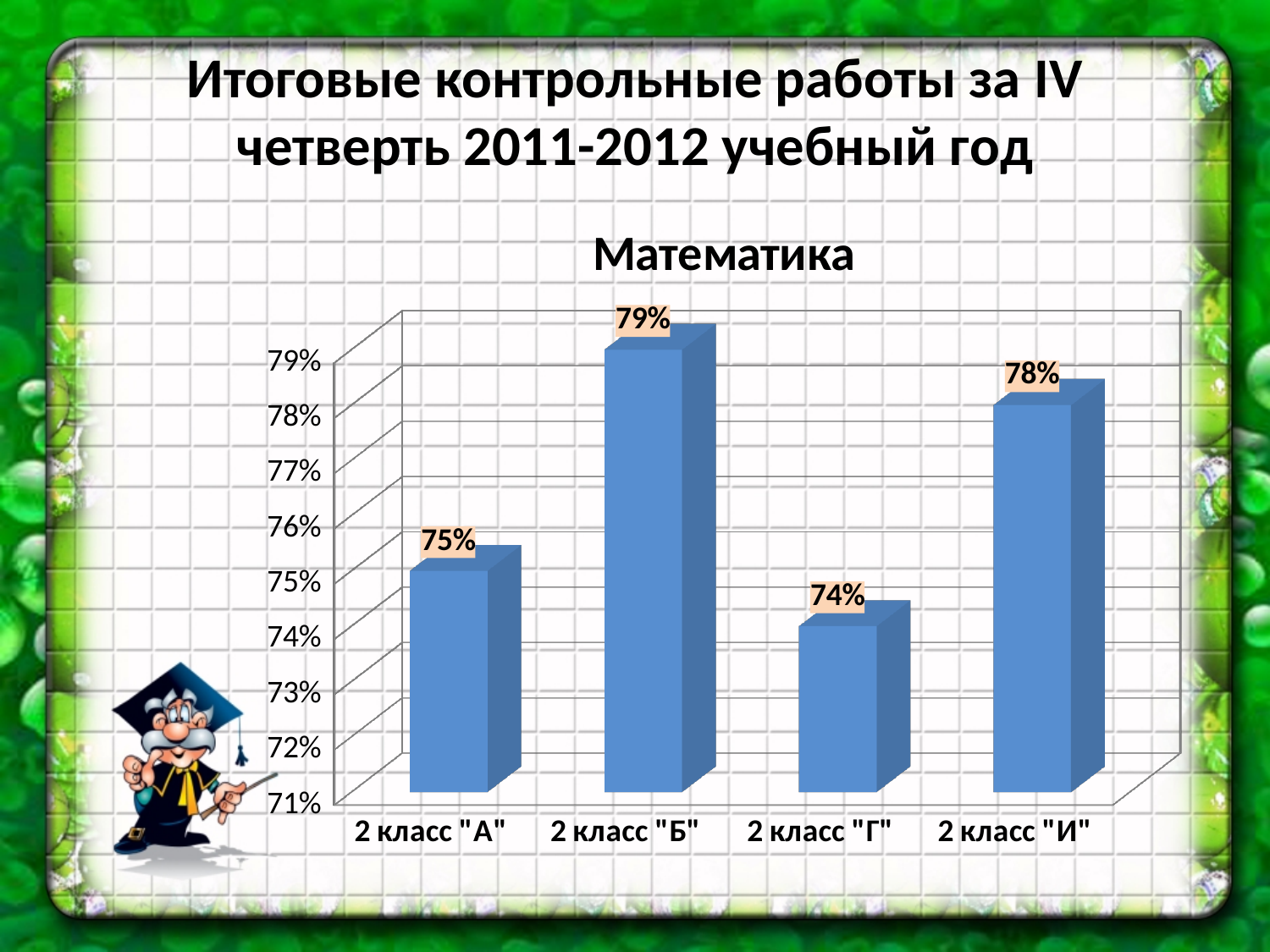
What is the value for 2 класс "Б"? 79% What is the value for 2 класс "А"? 75% What is the value for 2 класс "Г"? 74% Which class has the highest value? 2 класс "Б" What is the difference between the values for 2 класс "И" and 2 класс "А"? 3% How many classes are shown in the chart? 4 Which class has the lowest value? 2 класс "Г" What is the value for 2 класс "И"? 78% What kind of chart is shown? Bar chart Which is larger, the value for 2 класс "А" or 2 класс "И"? 2 класс "И" What is the difference between the values for 2 класс "Б" and 2 класс "Г"? 5% What is the title of the chart? Математика